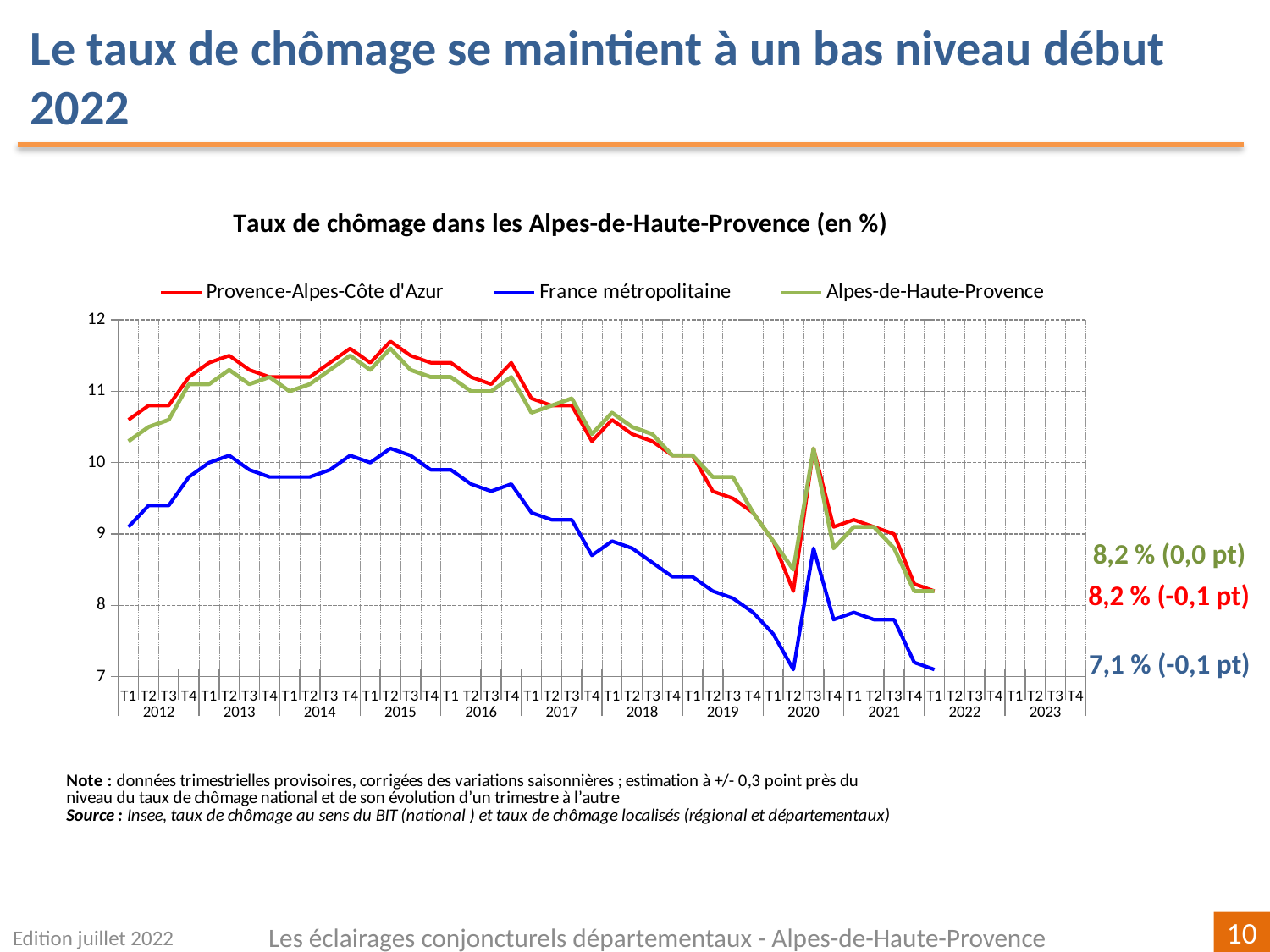
What is the latest unemployment rate shown for France métropolitaine? 7,1 % What is the title of the chart? Taux de chômage dans les Alpes-de-Haute-Provence (en %) What is the latest unemployment rate shown for Provence-Alpes-Côte d'Azur? 8,2 % At the latest point, which series has the lowest value? France métropolitaine What is the latest unemployment rate shown for Alpes-de-Haute-Provence? 8,2 % Is the value for France métropolitaine in T2 2020 greater or less than 8? less Is the value for Alpes-de-Haute-Provence in T2 2015 greater or less than 11? greater At the latest point, what is the difference between the Alpes-de-Haute-Provence rate and the France métropolitaine rate? 1,1 What kind of chart is shown on the slide? line chart What quarter-on-quarter change is annotated for France métropolitaine at the latest point? -0,1 pt How many series does the legend list? 3 Does the France métropolitaine line end higher or lower in T1 2022 than it started in T1 2012? lower